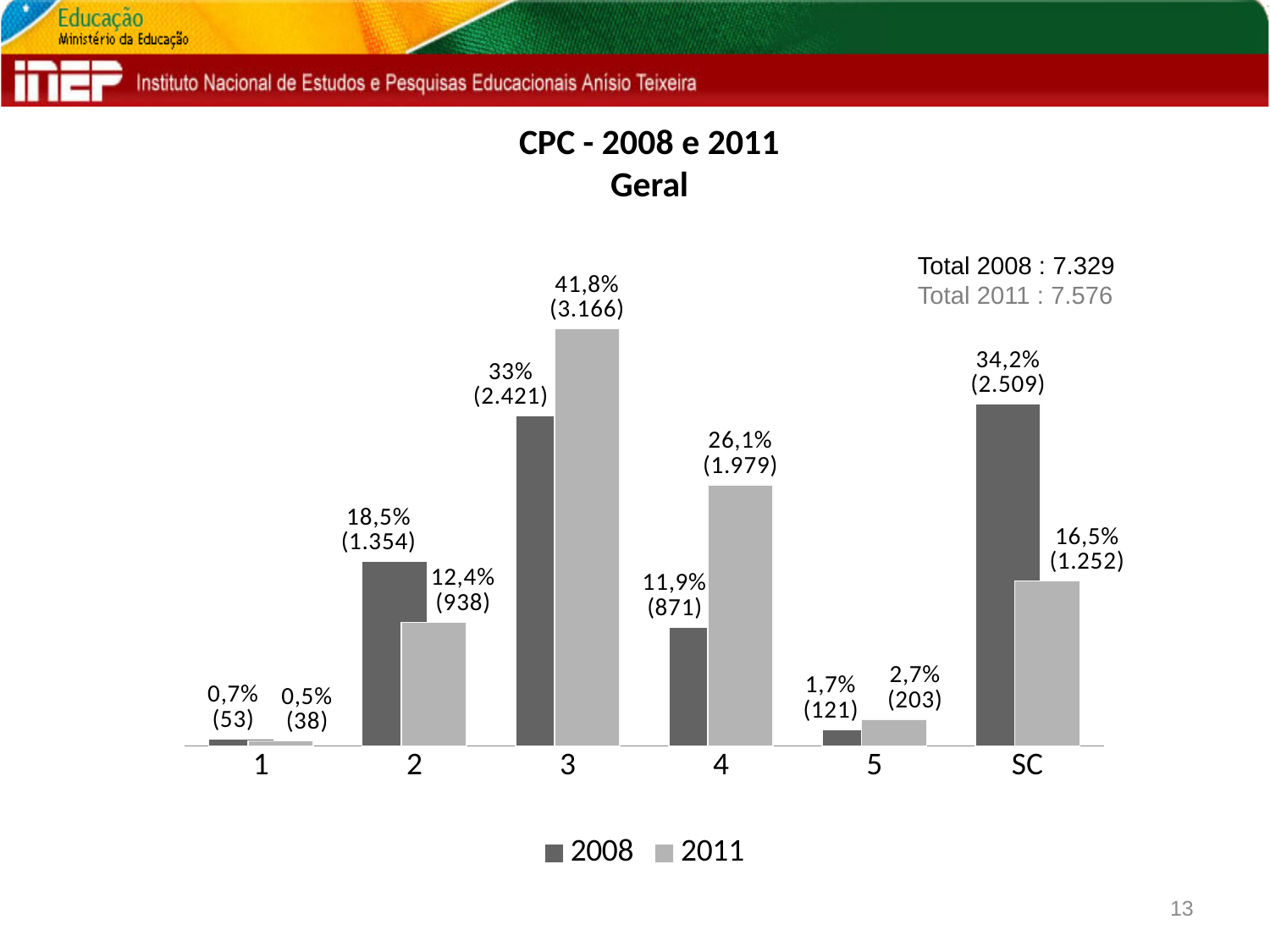
Which category has the highest value in the 2011 series? 3 What is the value for category 3 in the 2011 series? 41,8% (3.166) How many series does the legend list? 2 How many categories are shown on the x axis? 6 Which category has the lowest value in the 2008 series? 1 What is the total for 2011 shown on the slide? 7.576 What is the difference in percentage points between the 2011 and 2008 values for category 4? 14,2 What is the title of the chart? CPC - 2008 e 2011 Geral What percentage is shown for category SC in the 2008 series? 34,2% What kind of chart is shown on the slide? Bar chart For category SC, which series has the larger value, 2008 or 2011? 2008 What count is shown in parentheses for category 2 in the 2011 series? 938